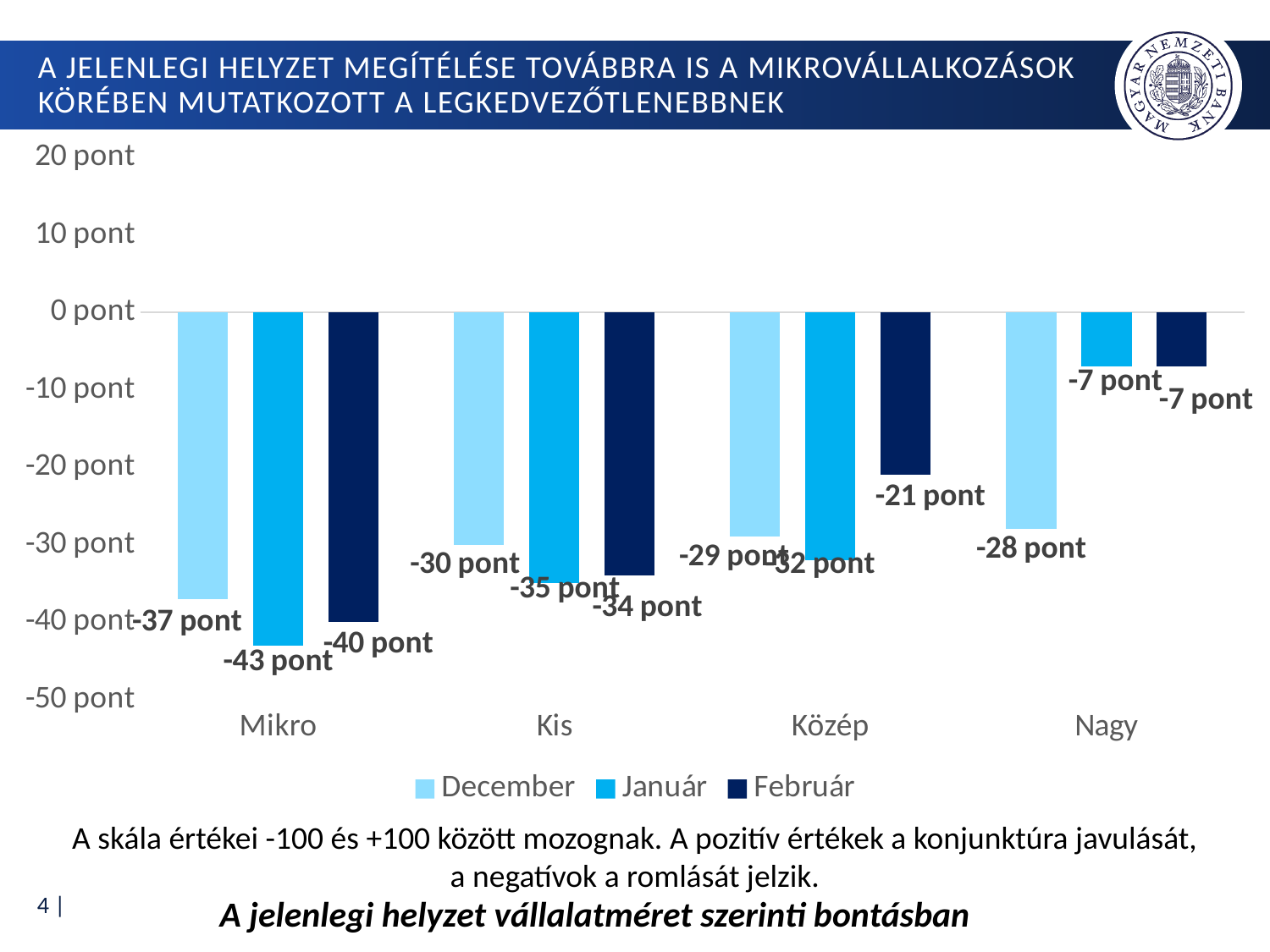
Which series is shown in the darkest blue in the legend? Február How many series does the legend list? 3 What is the difference between the December and Január values for Mikro? 6 pont What kind of chart is shown on the slide? Bar chart Which is larger, the December value for Kis or the December value for Közép? Közép Which category has the lowest Január value? Mikro What is the Január value for Kis? -35 pont What is the Február value for Mikro? -40 pont What is the December value for Nagy? -28 pont What is the Február value for Közép? -21 pont Which category has the highest Február value? Nagy How many categories are shown on the x axis? 4